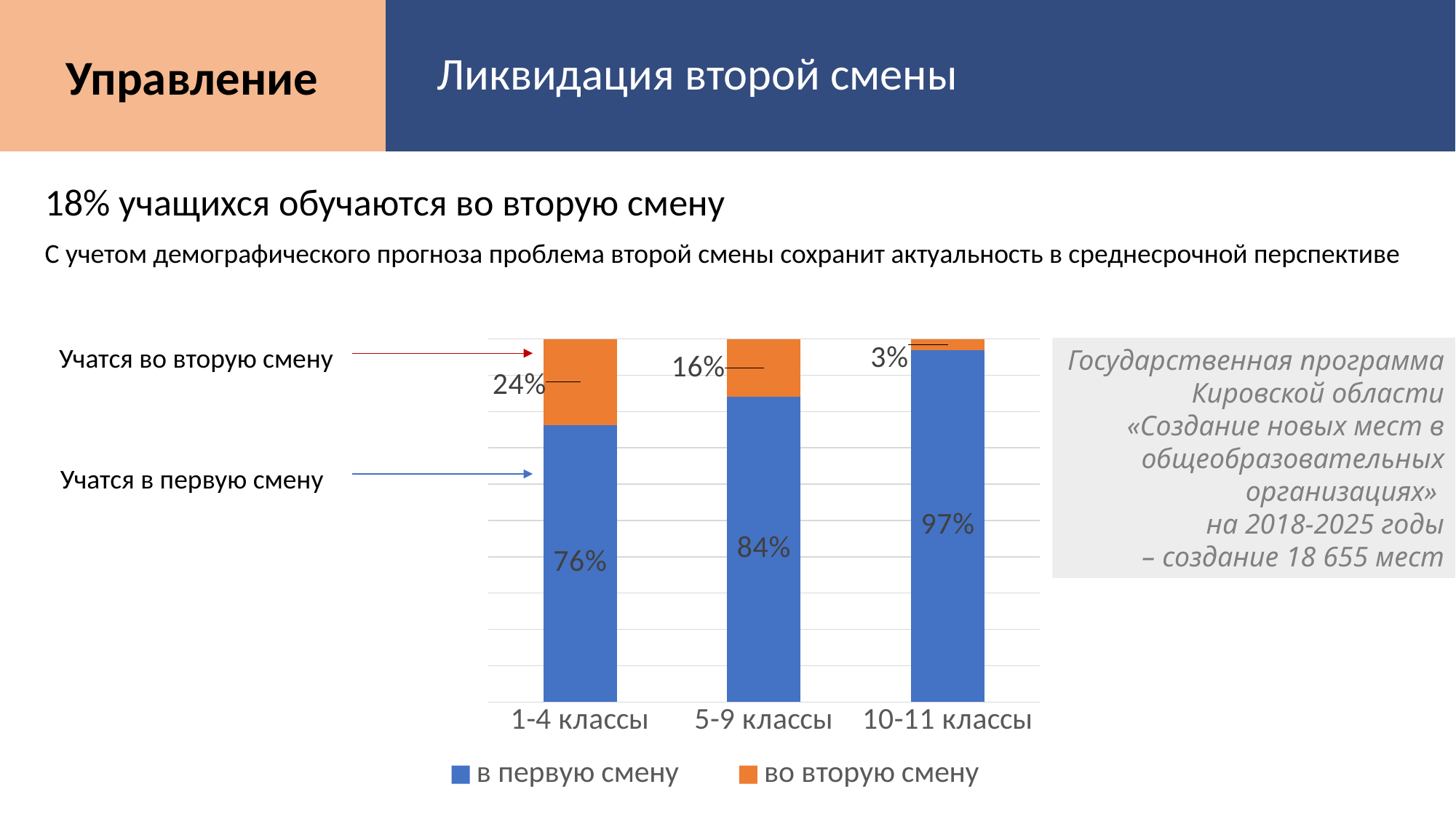
What share of students in 10-11 классы study во вторую смену? 3% Does the share of students studying в первую смену rise or fall from 1-4 классы to 10-11 классы? Rise Which grade group has the highest share of students studying во вторую смену? 1-4 классы What is the difference between the share of students в первую смену in 10-11 классы and in 1-4 классы? 21% What kind of chart is shown on the slide? Stacked bar chart What share of students in 1-4 классы study в первую смену? 76% How many series does the chart legend list? 2 Which is larger: the share во вторую смену for 1-4 классы or for 5-9 классы? 1-4 классы Which grade group has the lowest share of students studying в первую смену? 1-4 классы How many grade groups are shown on the x axis of the chart? 3 What share of students in 5-9 классы study во вторую смену? 16% What share of students in 10-11 классы study в первую смену? 97%